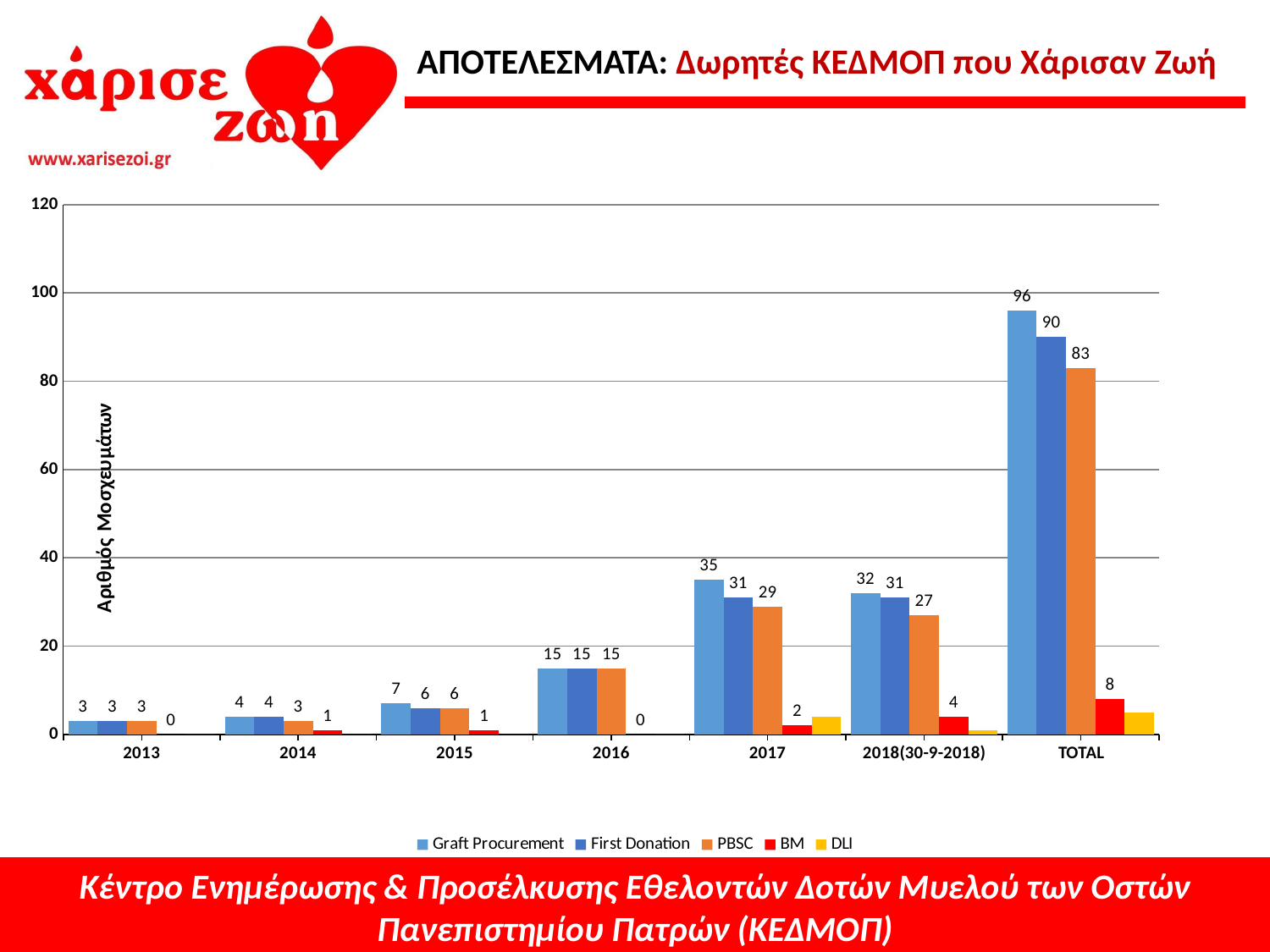
What is the First Donation value for 2016? 15 How many series does the legend list? 5 Among the individual years (excluding TOTAL), which year has the highest Graft Procurement value? 2017 How many categories are shown on the x axis? 7 Does the Graft Procurement value rise or fall from 2013 to 2017? rise What is the value for Graft Procurement in the TOTAL category? 96 What is the PBSC value for 2017? 29 Is the DLI value in the TOTAL category greater or less than 20? less Which is larger: the Graft Procurement value for 2017 or for 2018(30-9-2018)? 2017 What is the difference between the First Donation and PBSC values in the TOTAL category? 7 What is the BM value for 2018(30-9-2018)? 4 What kind of chart is shown on the slide? bar chart